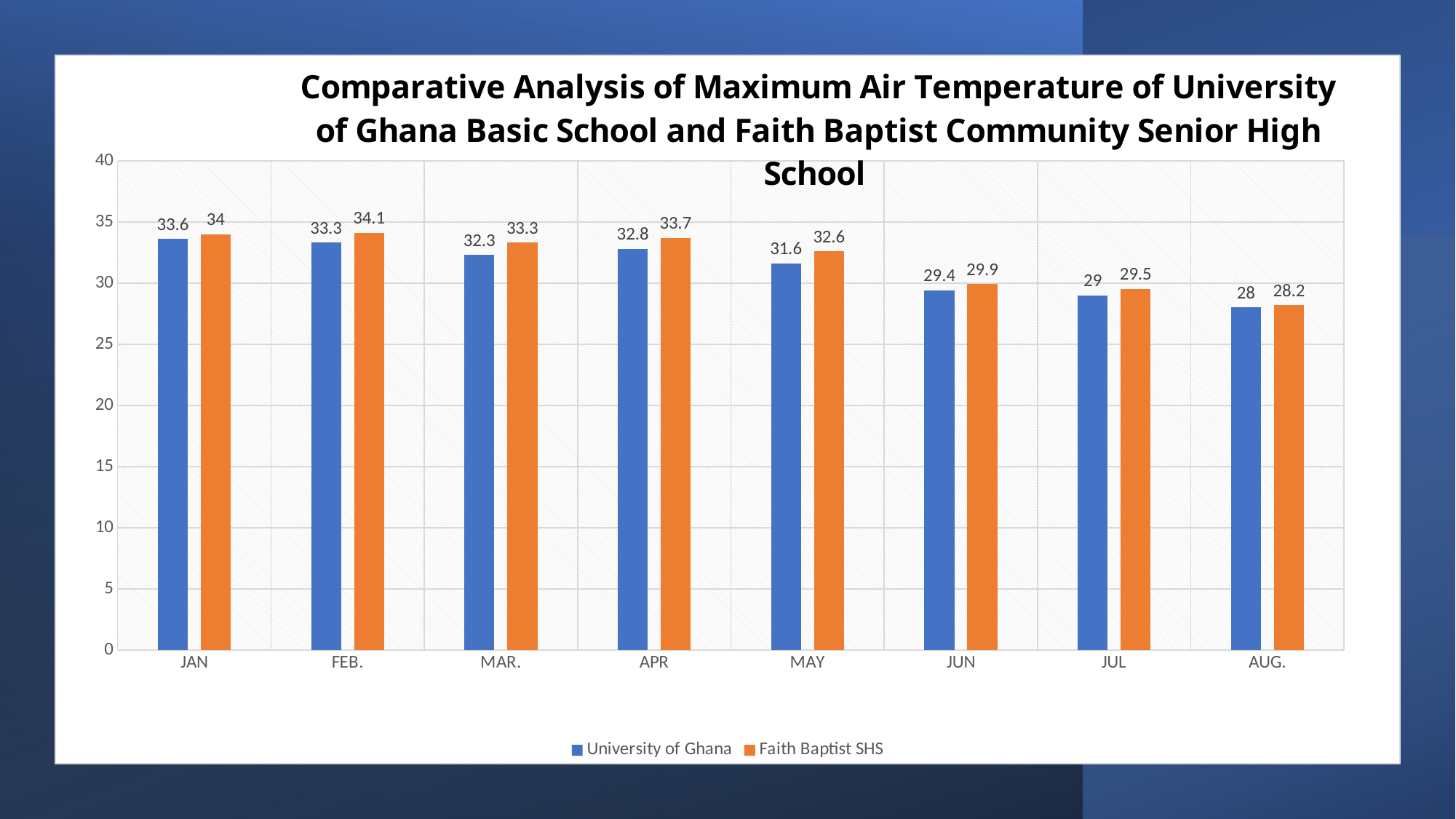
What is the Faith Baptist SHS value for AUG.? 28.2 Which month has the lowest University of Ghana value? AUG. What is the University of Ghana value for JAN? 33.6 What is the difference between the Faith Baptist SHS and University of Ghana values for APR? 0.9 Which month has the highest Faith Baptist SHS value? FEB. How many series does the legend list? 2 Which is larger in JUN, the University of Ghana value or the Faith Baptist SHS value? Faith Baptist SHS Do the University of Ghana values rise or fall from JAN to AUG.? Fall What is the Faith Baptist SHS value for FEB.? 34.1 What is the University of Ghana value for MAY? 31.6 How many months are shown on the x axis? 8 What kind of chart is shown on the slide? Bar chart